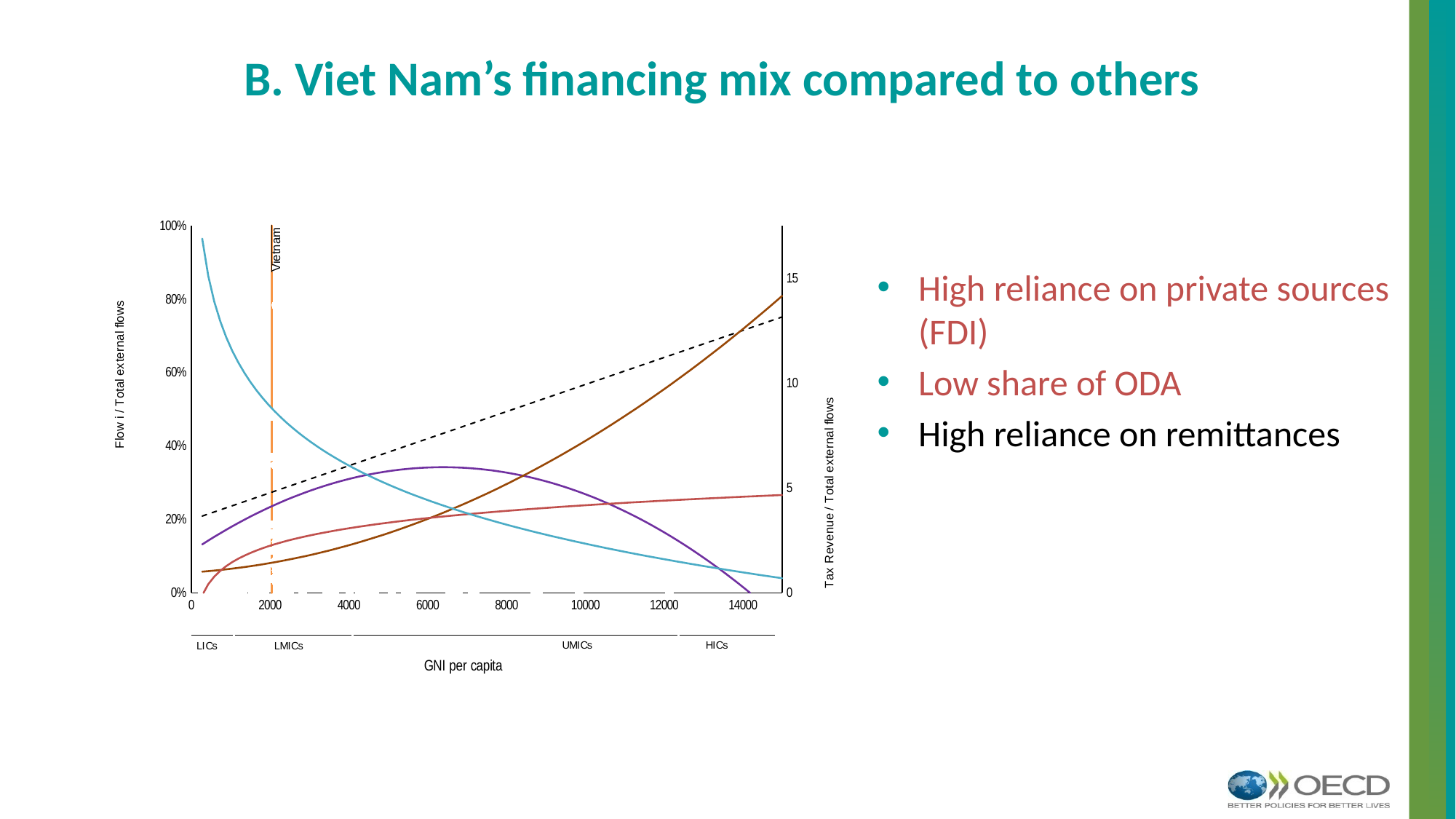
Does the brown line rise or fall as GNI per capita increases? Rises What is the label of the right-hand vertical axis of the chart? Tax Revenue / Total external flows What kind of chart is shown on the slide? Line chart Does the light blue line rise or fall as GNI per capita increases? Falls Is the value of the light blue line at the left edge of the chart greater or less than 80%? greater At a GNI per capita of 2000, which line is higher: the light blue line or the purple line? The light blue line At a GNI per capita of 12000, which line is higher: the brown line or the red line? The brown line At which GNI per capita tick is the vertical dashed line labelled Vietnam drawn? 2000 Does the black dashed line rise or fall as GNI per capita increases? Rises What is the label of the x axis of the chart? GNI per capita How many income-group categories (LICs, LMICs, UMICs, HICs) are marked along the x axis? 4 Is the value of the light blue line at a GNI per capita of 14000 greater or less than 20%? less